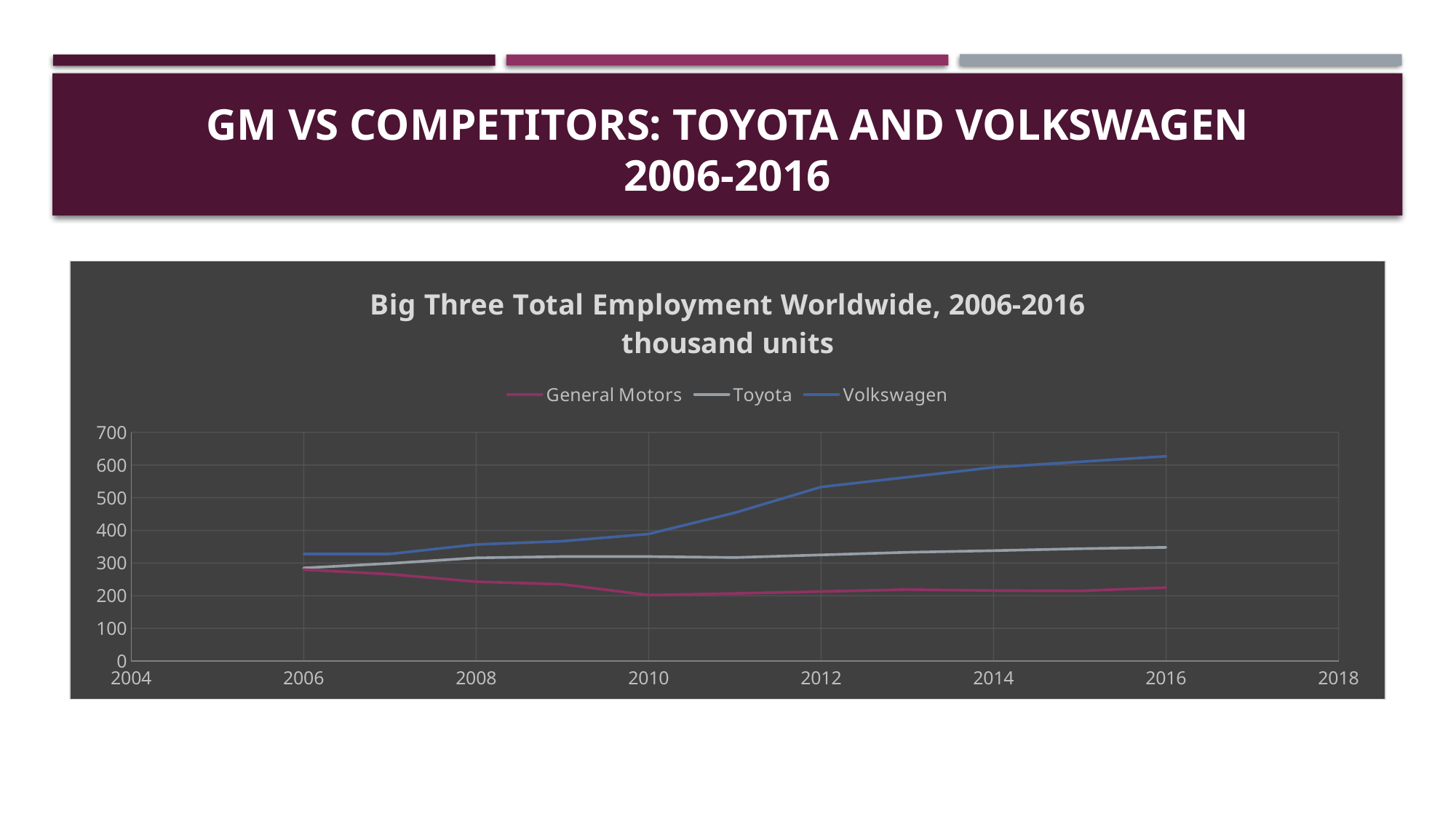
How many series does the chart's legend list? 3 What kind of chart is shown on the slide? line chart Does the Volkswagen line rise or fall from 2006 to 2016? rise Is the value for Volkswagen in 2012 greater or less than 500? greater Is the value for General Motors in 2010 greater or less than 300? less Which series is drawn with the blue line? Volkswagen What is the title of the chart? Big Three Total Employment Worldwide, 2006-2016 thousand units Is the value for Volkswagen in 2016 greater or less than 600? greater Does the General Motors line rise or fall from 2006 to 2010? fall In 2012, which is larger: the value for Toyota or the value for General Motors? Toyota Which company has the highest employment in 2016? Volkswagen Which company has the lowest employment in 2016? General Motors